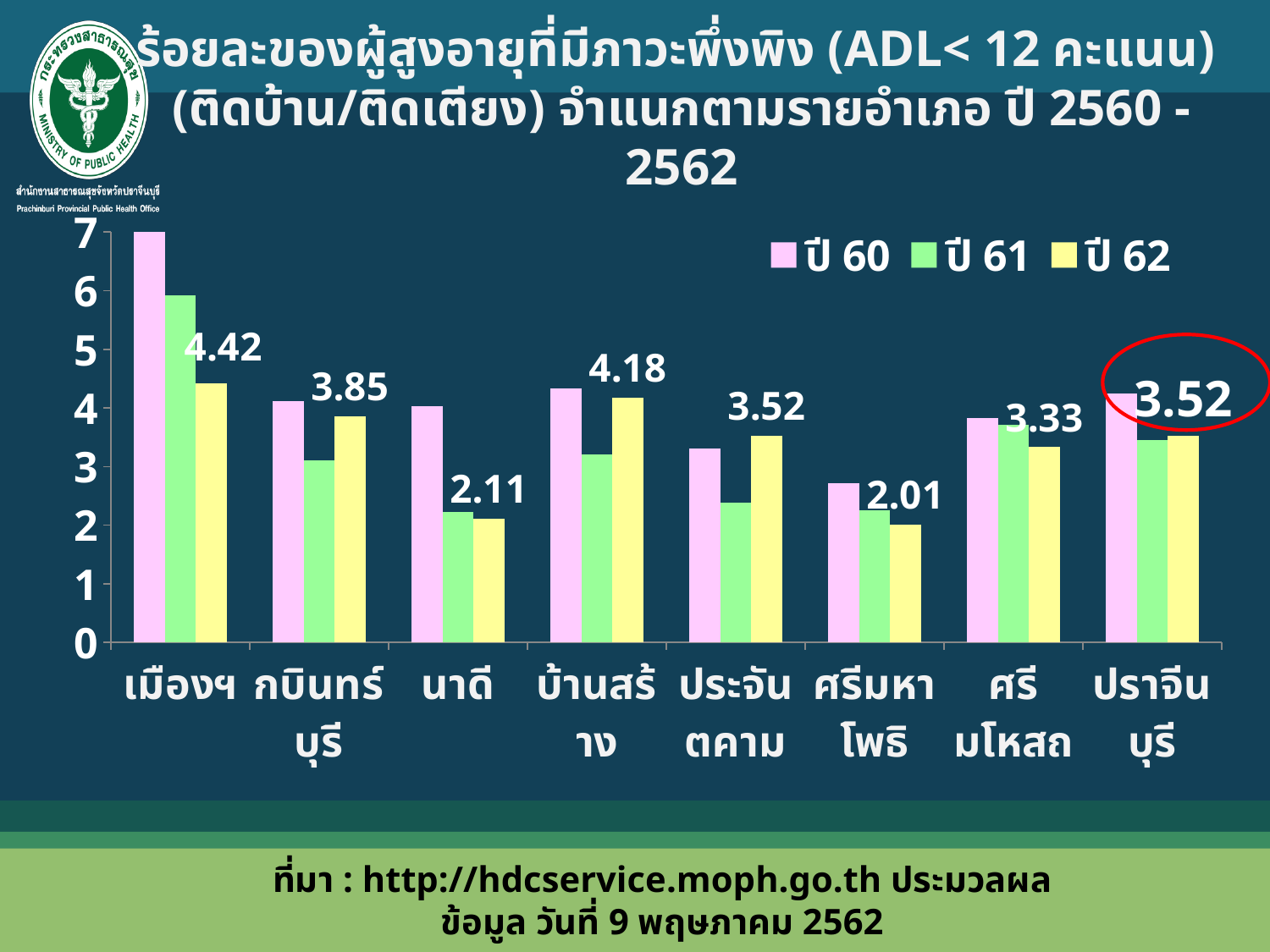
What is the value for ปี 62 in เมืองฯ? 4.42 How many districts are shown on the x axis? 8 What is the difference between the ปี 62 values for เมืองฯ and ศรีมหาโพธิ? 2.41 What is the value for ปี 62 in ศรีมหาโพธิ? 2.01 Which district has the highest ปี 62 value? เมืองฯ Is the ปี 60 value for เมืองฯ greater or less than 6? greater Is the ปี 61 value for นาดี greater or less than 3? less What is the value for ปี 62 in นาดี? 2.11 Which has the larger ปี 62 value, กบินทร์บุรี or บ้านสร้าง? บ้านสร้าง What kind of chart is shown on the slide? bar chart How many series does the legend list? 3 Which district has the lowest ปี 62 value? ศรีมหาโพธิ